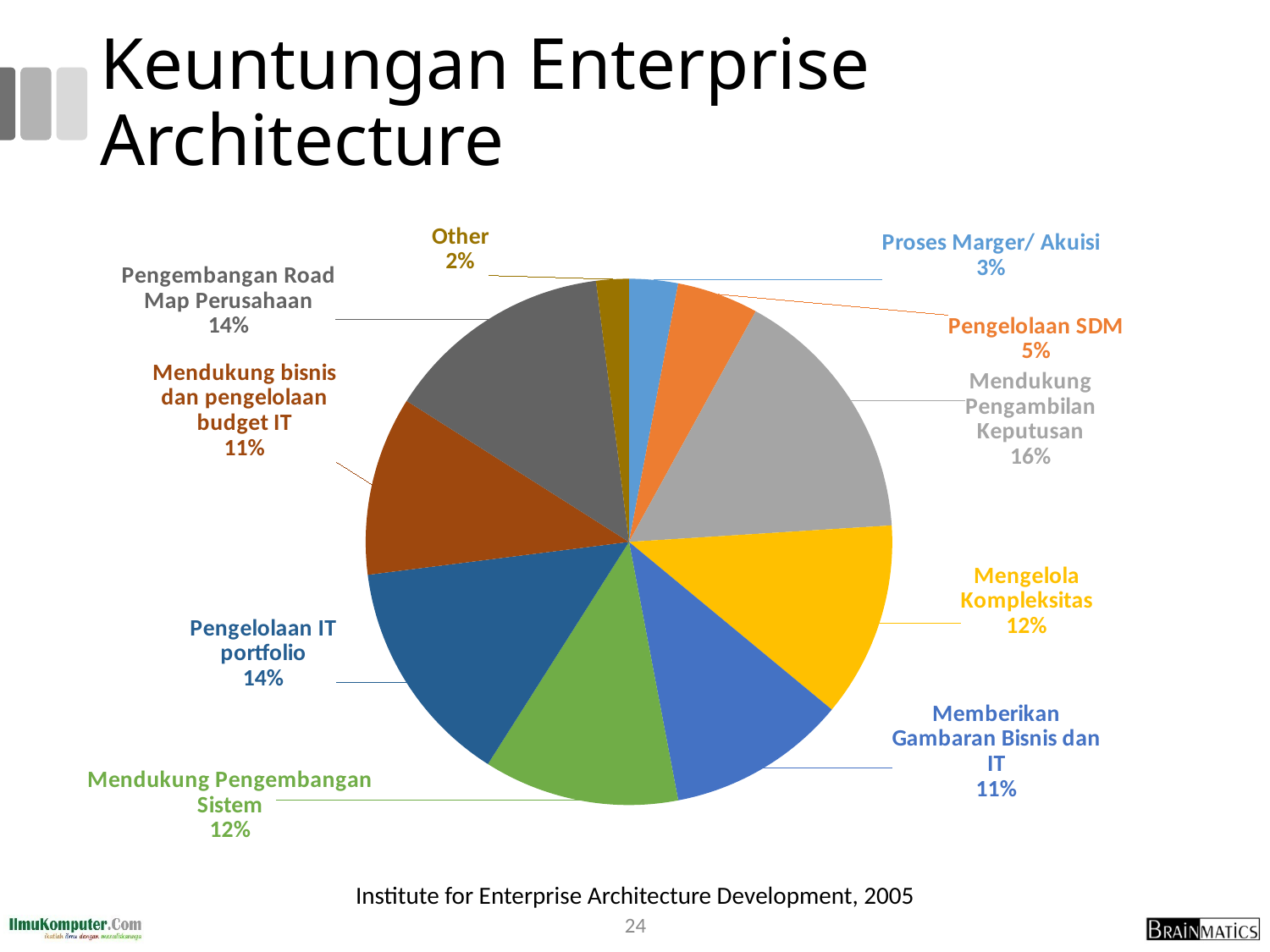
What percentage is shown for Pengelolaan SDM? 5% What share of the pie does Mendukung Pengambilan Keputusan have? 16% What percentage is shown for Pengelolaan IT portfolio? 14% How many slices does the pie chart have? 10 What source is cited below the chart? Institute for Enterprise Architecture Development, 2005 What is the difference in percentage between Mendukung Pengambilan Keputusan and Pengelolaan SDM? 11% What is the difference in percentage between Pengembangan Road Map Perusahaan and Other? 12% Which category has the smallest slice of the pie? Other What percentage is shown for Proses Marger/ Akuisi? 3% Which category has the largest slice of the pie? Mendukung Pengambilan Keputusan Which is larger, Mengelola Kompleksitas or Memberikan Gambaran Bisnis dan IT? Mengelola Kompleksitas What kind of chart is shown on the slide? pie chart